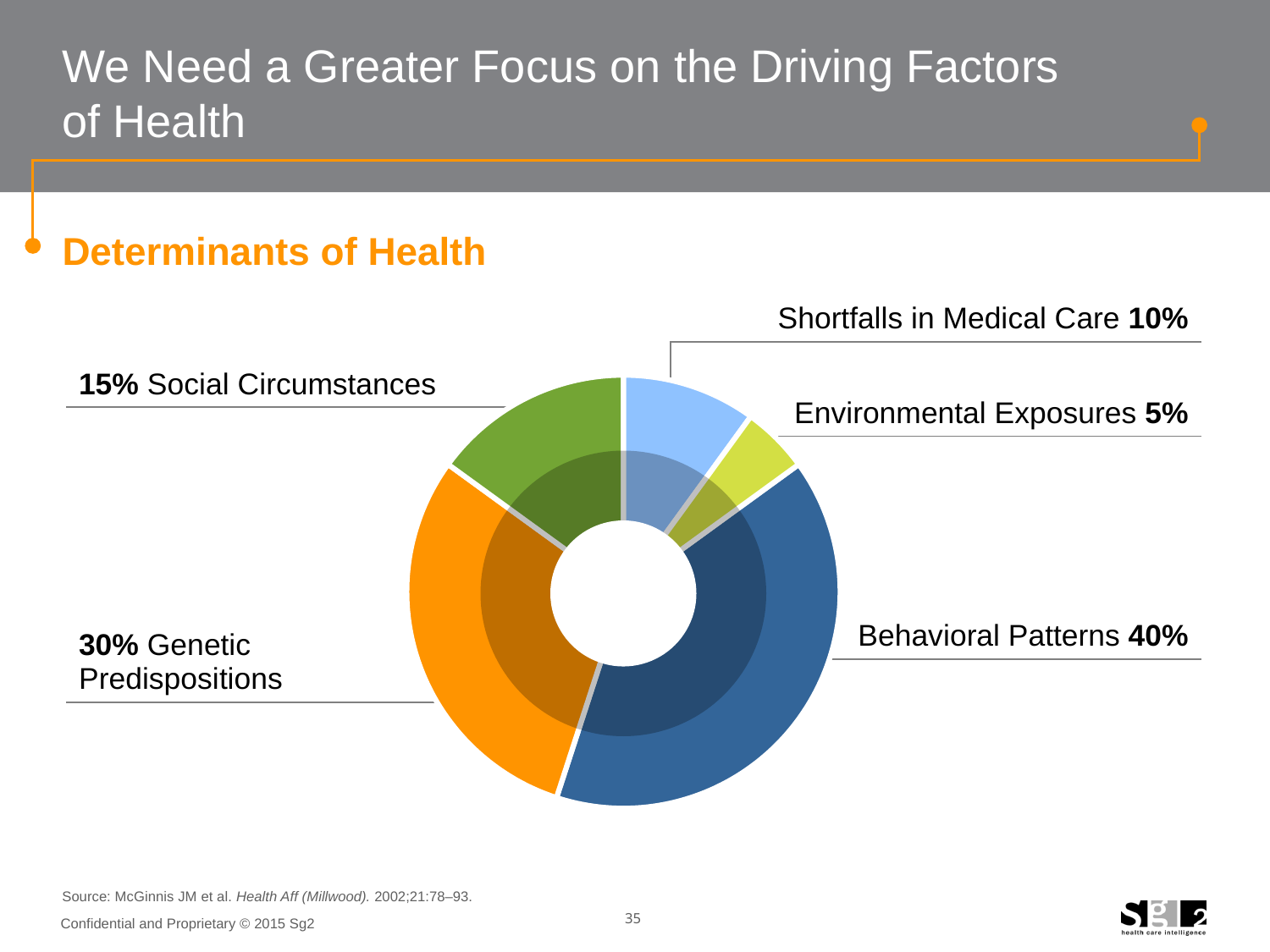
What is the title of the chart? Determinants of Health What percentage is shown for Behavioral Patterns? 40% What percentage is shown for Social Circumstances? 15% What percentage is shown for Environmental Exposures? 5% How many determinants of health are shown in the chart? 5 Which determinant of health has the largest share? Behavioral Patterns What percentage is shown for Genetic Predispositions? 30% Which is larger, the share for Social Circumstances or the share for Shortfalls in Medical Care? Social Circumstances What is the difference between the shares for Behavioral Patterns and Genetic Predispositions? 10% Which determinant of health has the smallest share? Environmental Exposures What percentage is shown for Shortfalls in Medical Care? 10% What kind of chart is used to show the determinants of health? Doughnut chart